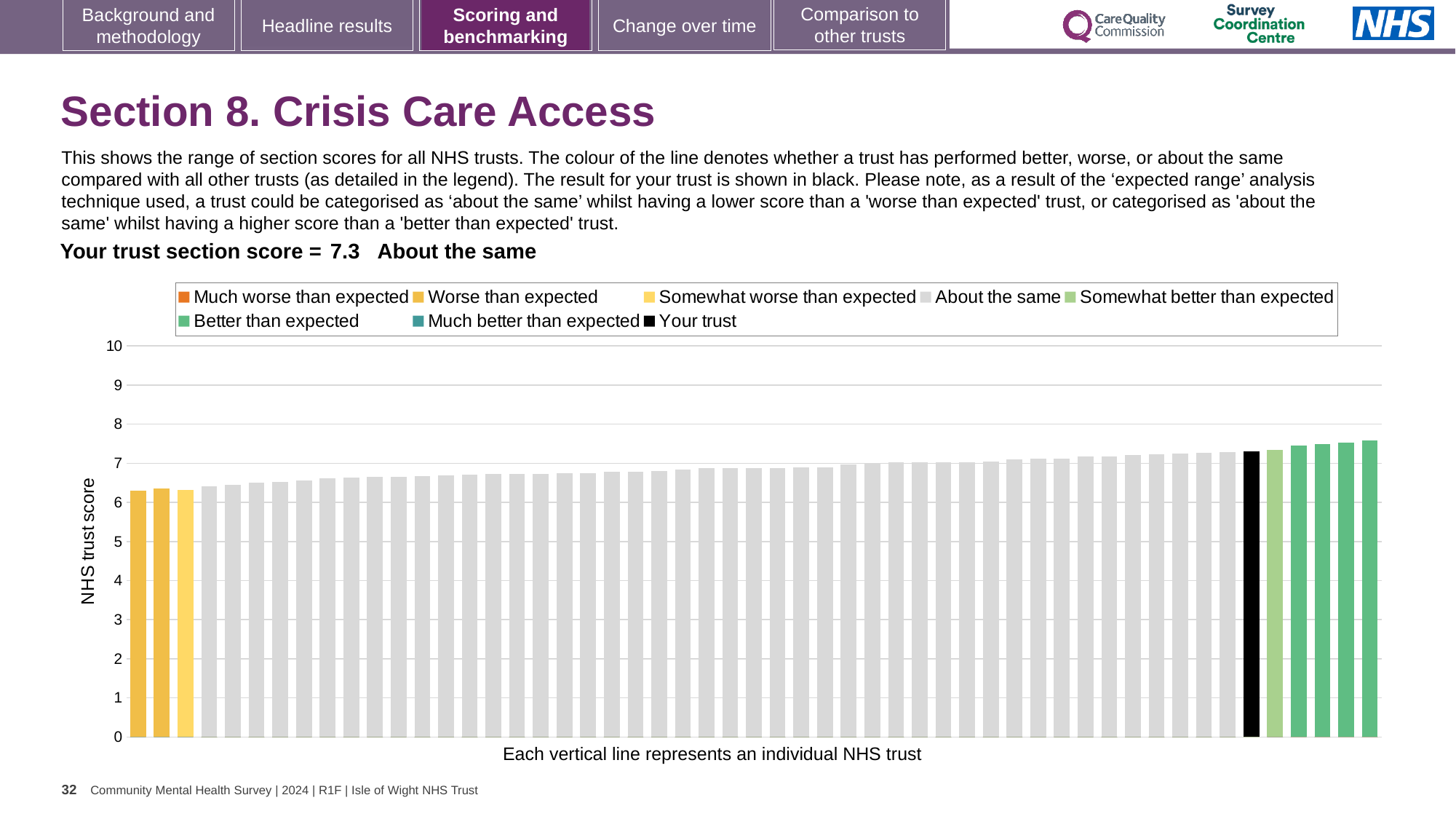
What is the label on the y axis of the chart? NHS trust score How many entries does the chart legend list? 8 Is the value of the shortest bar on the chart greater or less than 6? greater What is the highest value shown on the y axis of the chart? 10 Which is larger: the value of the black 'Your trust' bar or the value of the leftmost bar? the black 'Your trust' bar Is the value of the black 'Your trust' bar greater or less than 7? greater Is the value of the tallest bar on the chart greater or less than 8? less Do the bar values rise or fall moving from left to right along the x axis? rise What is the section score for your trust shown on the chart? 7.3 What kind of chart is shown on the slide? bar chart Which category is your trust placed in according to the text above the chart? About the same